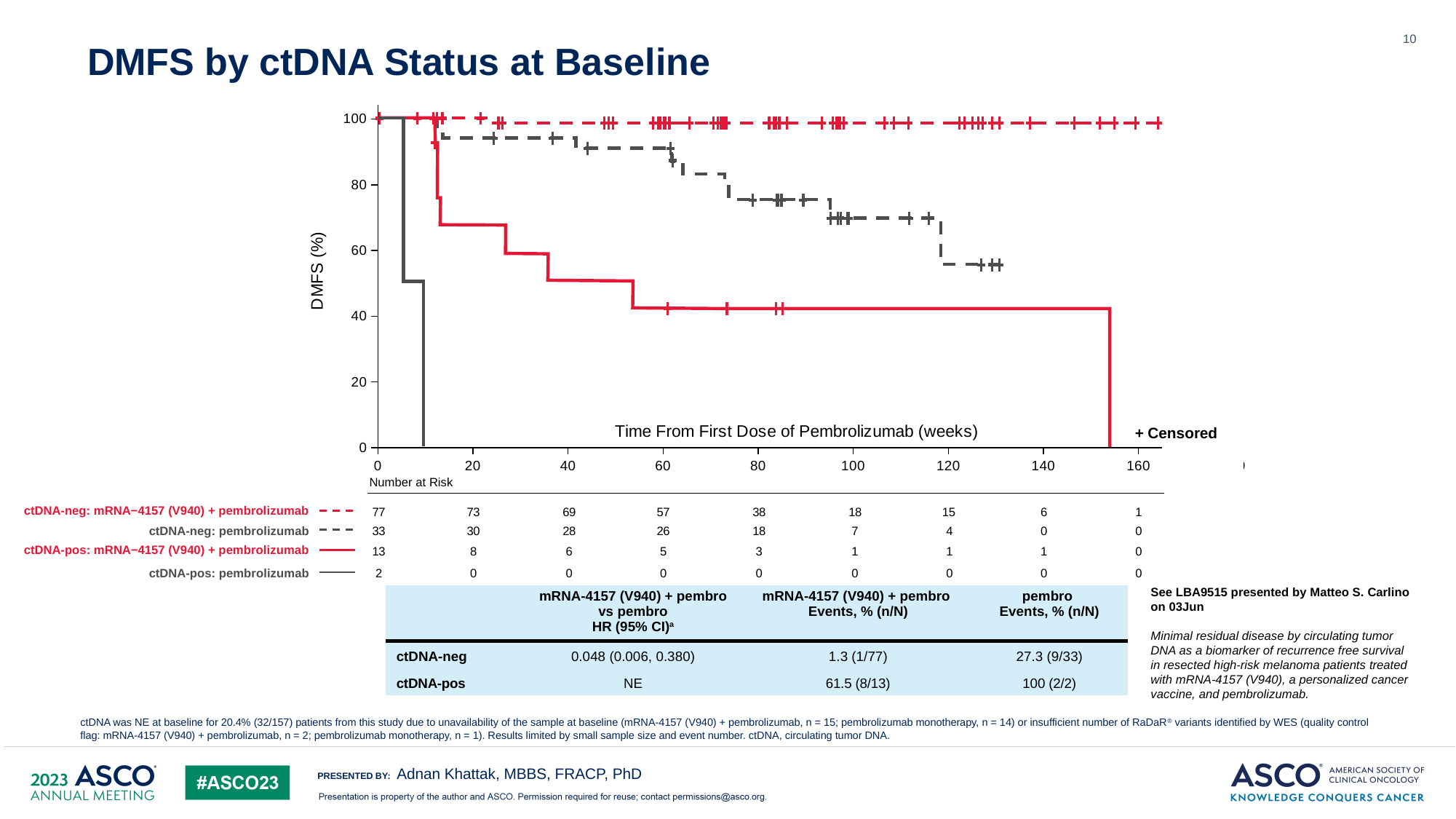
What kind of chart is shown on the slide? line chart Is the DMFS value of the ctDNA-neg: pembrolizumab curve at week 100 greater or less than 60? greater Which group has the highest number at risk at week 60? ctDNA-neg: mRNA-4157 (V940) + pembrolizumab Is the DMFS value of the ctDNA-pos: mRNA-4157 (V940) + pembrolizumab curve at week 100 greater or less than 60? less What is the number at risk at week 80 for ctDNA-neg: pembrolizumab? 18 Does the ctDNA-pos: pembrolizumab curve rise or fall over time? fall How many series does the legend list? 4 What is the x-axis title of the chart? Time From First Dose of Pembrolizumab (weeks) At week 0, what is the difference in number at risk between ctDNA-neg: mRNA-4157 (V940) + pembrolizumab and ctDNA-neg: pembrolizumab? 44 What is the number at risk at week 40 for ctDNA-pos: mRNA-4157 (V940) + pembrolizumab? 6 What is the number at risk at week 0 for ctDNA-neg: mRNA-4157 (V940) + pembrolizumab? 77 At week 20, which group has more patients at risk: ctDNA-neg: pembrolizumab or ctDNA-pos: mRNA-4157 (V940) + pembrolizumab? ctDNA-neg: pembrolizumab